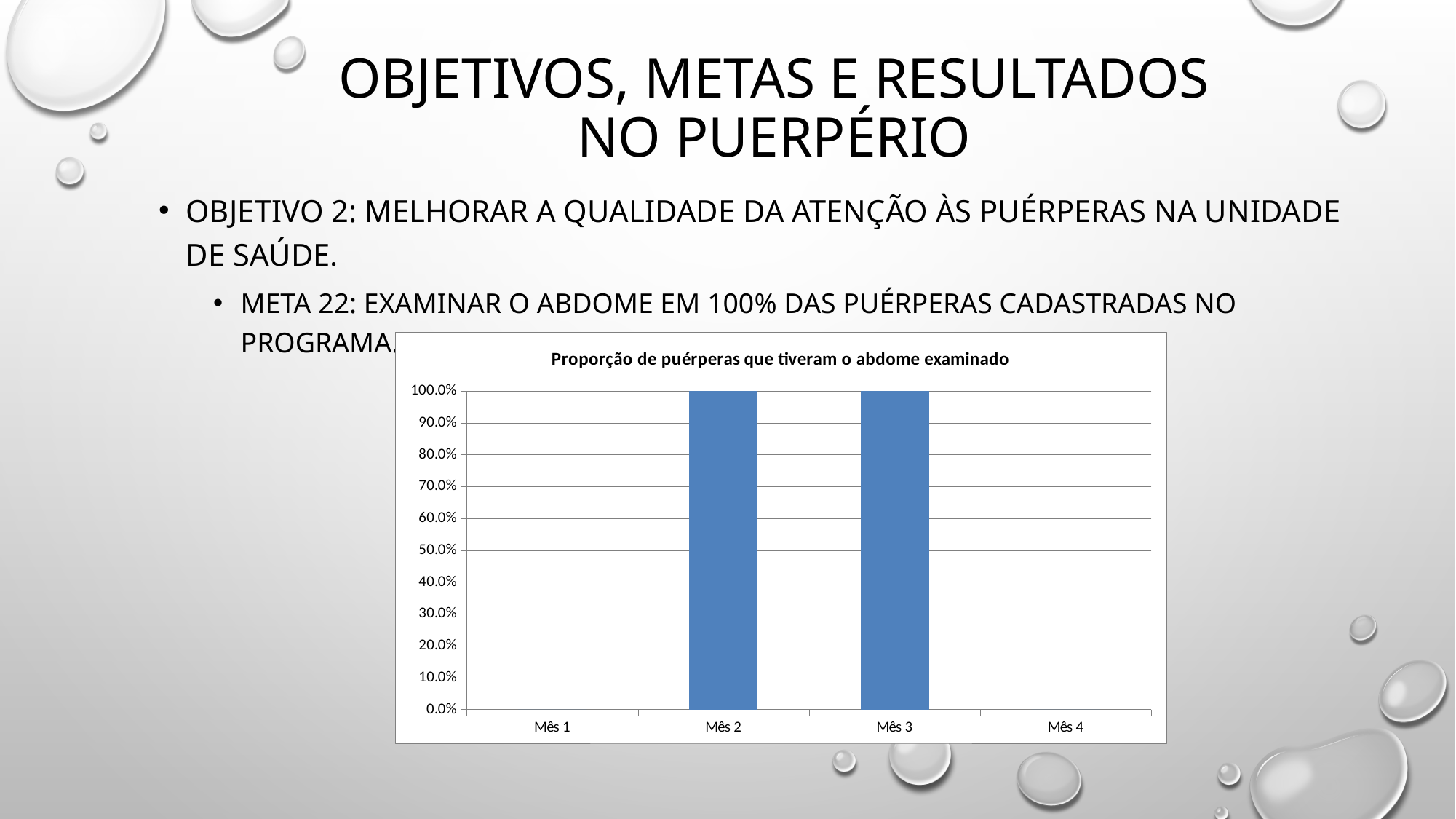
Is the value for Mês 3 greater or less than 50.0%? greater Does the value rise or fall from Mês 3 to Mês 4? fall Which is larger, the value for Mês 2 or the value for Mês 4? Mês 2 What is the value for Mês 2? 100.0% What type of chart is shown on the slide? bar chart How many months have a visible bar in the chart? 2 Which months reach 100.0% in the chart? Mês 2 and Mês 3 How many months (categories) are shown on the x axis of the chart? 4 What is the title of the chart? Proporção de puérperas que tiveram o abdome examinado What is the value for Mês 3? 100.0% What is the value for Mês 1? 0.0% What is the difference between the value for Mês 2 and the value for Mês 1? 100.0%